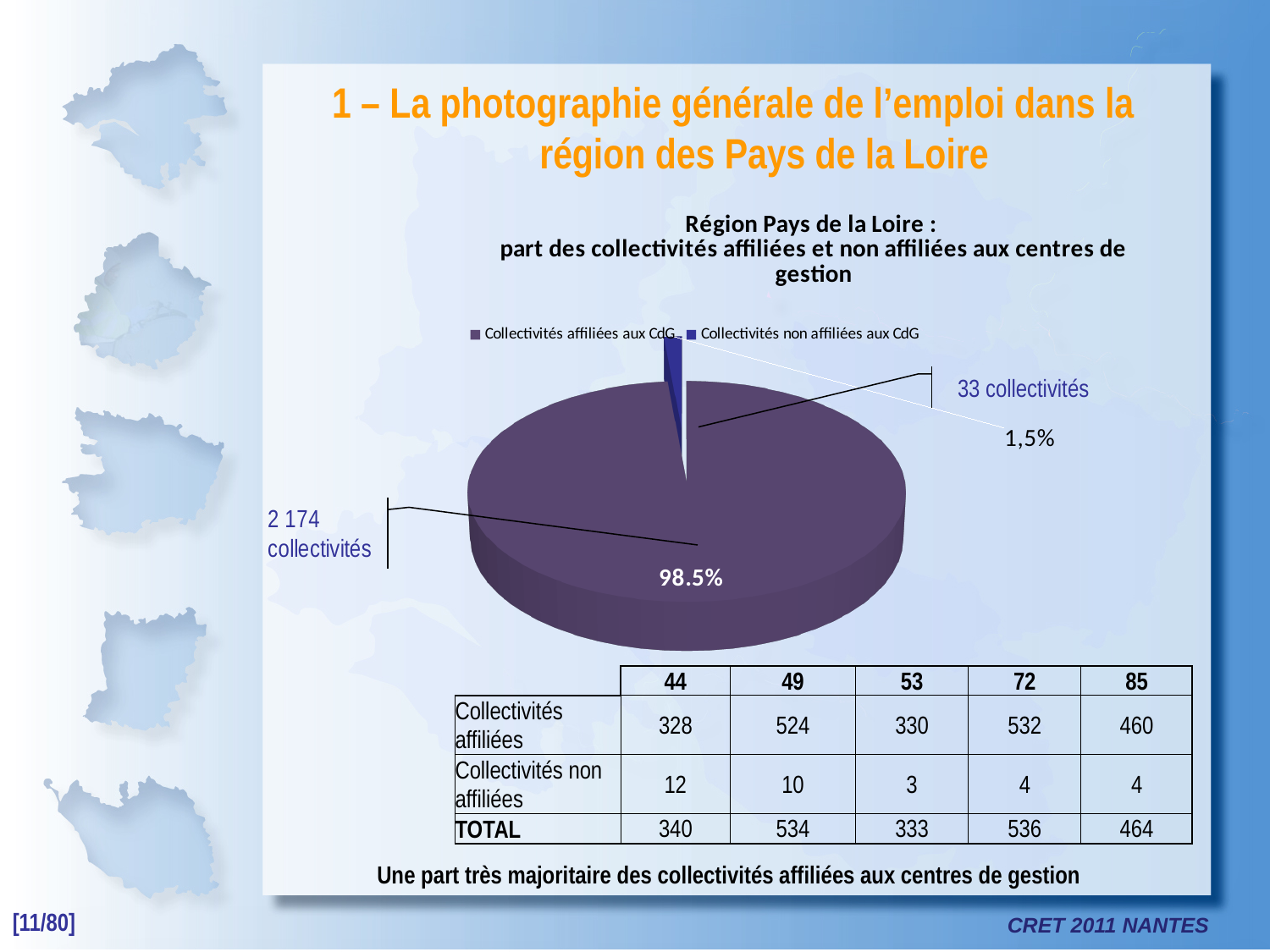
What share of the pie is taken by the collectivités affiliées aux CdG? 98.5% What share of the pie is taken by the collectivités non affiliées aux CdG? 1,5% How many collectivités are non affiliées aux CdG according to the pie chart label? 33 collectivités How many series does the legend of the pie chart list? 2 Which slice of the pie chart is the smallest? Collectivités non affiliées aux CdG Which is larger: the number of collectivités affiliées or the number of collectivités non affiliées? Collectivités affiliées Which slice of the pie chart is the largest? Collectivités affiliées aux CdG How many slices does the pie chart have? 2 What is the difference between the number of collectivités affiliées (2 174) and non affiliées (33)? 2 141 What is the title of the pie chart? Région Pays de la Loire : part des collectivités affiliées et non affiliées aux centres de gestion How many collectivités are affiliées aux CdG according to the pie chart label? 2 174 collectivités What kind of chart is shown on the slide? Pie chart